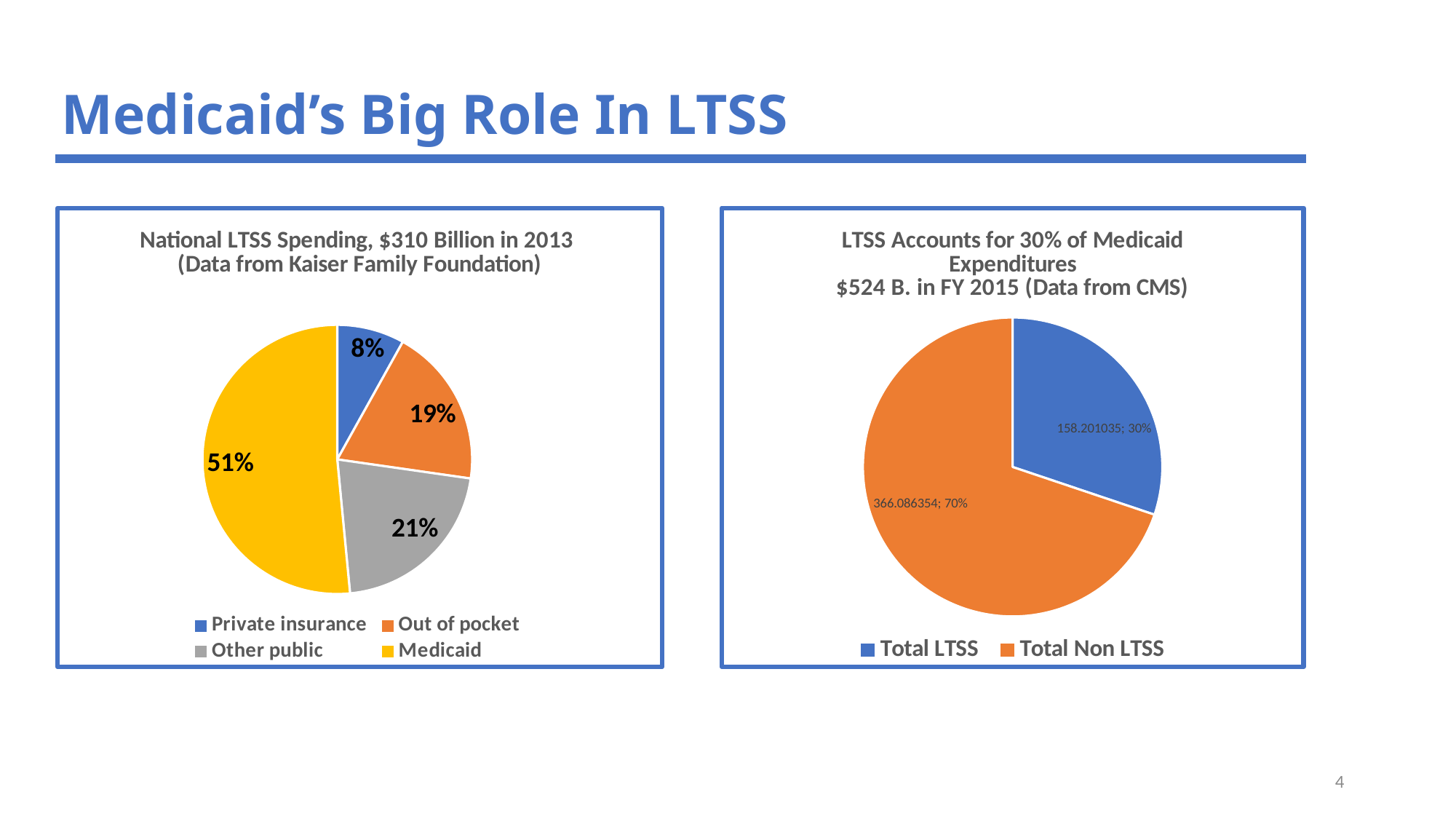
In the left chart (National LTSS Spending), what share of spending is Private insurance? 8% In the left chart (National LTSS Spending), which category has the smallest share? Private insurance What type of chart is the right chart (LTSS Accounts for 30% of Medicaid Expenditures)? Pie chart In the left chart (National LTSS Spending), what share of spending is Other public? 21% In the left chart (National LTSS Spending), which category has the largest share? Medicaid In the left chart (National LTSS Spending), what share of spending is Out of pocket? 19% In the left chart (National LTSS Spending), what share of spending is Medicaid? 51% In the left chart (National LTSS Spending), how many categories does the pie show? 4 In the right chart (LTSS Accounts for 30% of Medicaid Expenditures), which is larger, Total LTSS or Total Non LTSS? Total Non LTSS In the right chart (LTSS Accounts for 30% of Medicaid Expenditures), what is the value labelled for Total LTSS? 158.201035 In the left chart (National LTSS Spending), how many percentage points larger is Medicaid's share than Out of pocket's share? 32 In the right chart (LTSS Accounts for 30% of Medicaid Expenditures), what percentage share is Total Non LTSS? 70%